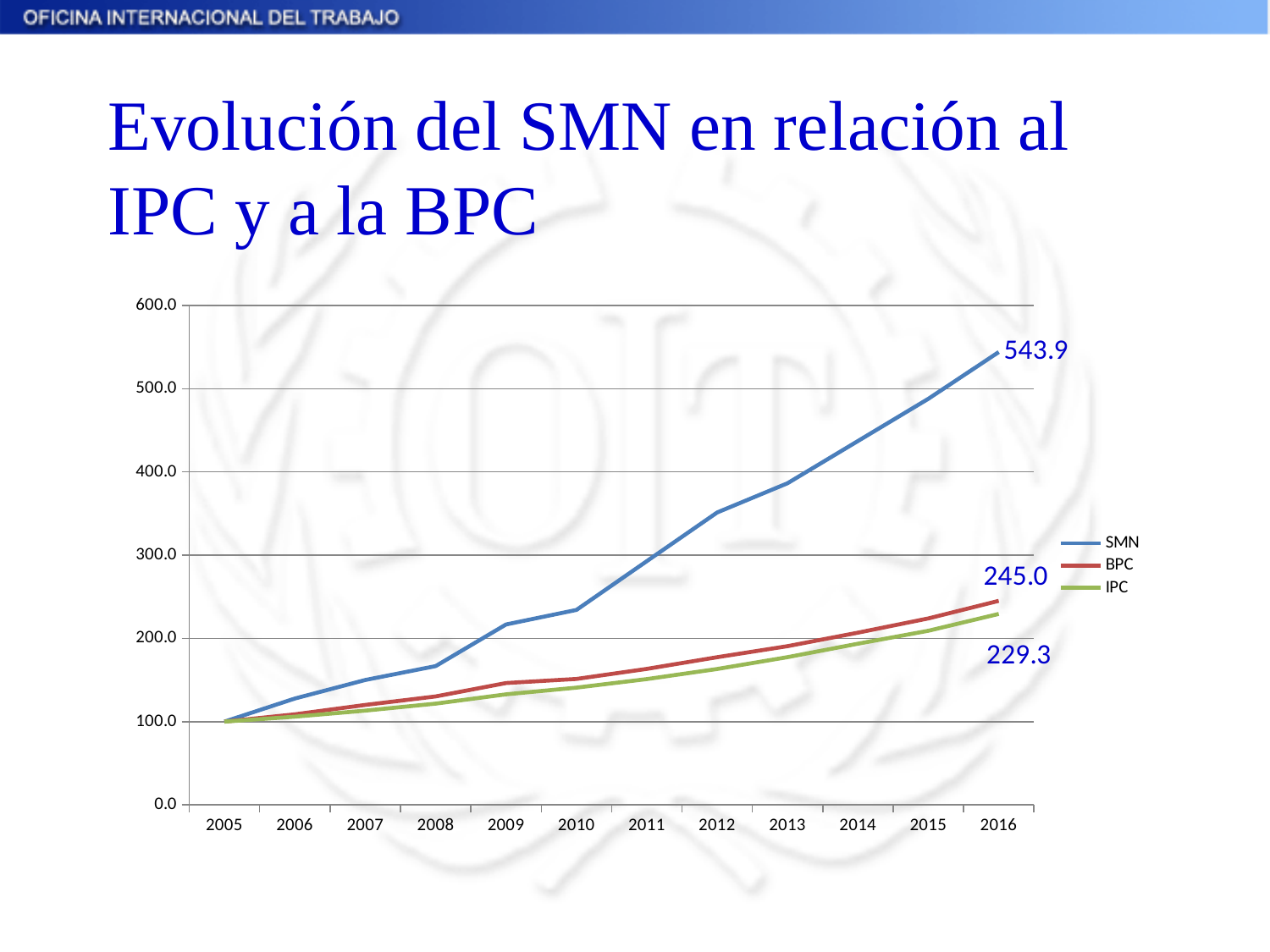
Is the value for SMN in 2012 greater or less than 300.0? greater What is the difference between the SMN and BPC values in 2016? 298.9 What kind of chart is shown on the slide? Line chart What is the value of BPC in 2016? 245.0 What is the value of IPC in 2016? 229.3 What is the value of SMN in 2016? 543.9 What is the difference between the BPC and IPC values in 2016? 15.7 Which is larger in 2016, BPC or IPC? BPC Which series has the highest value in 2016? SMN Which series has the lowest value in 2016? IPC How many series does the legend list? 3 Does the SMN series rise or fall from 2005 to 2016? Rise